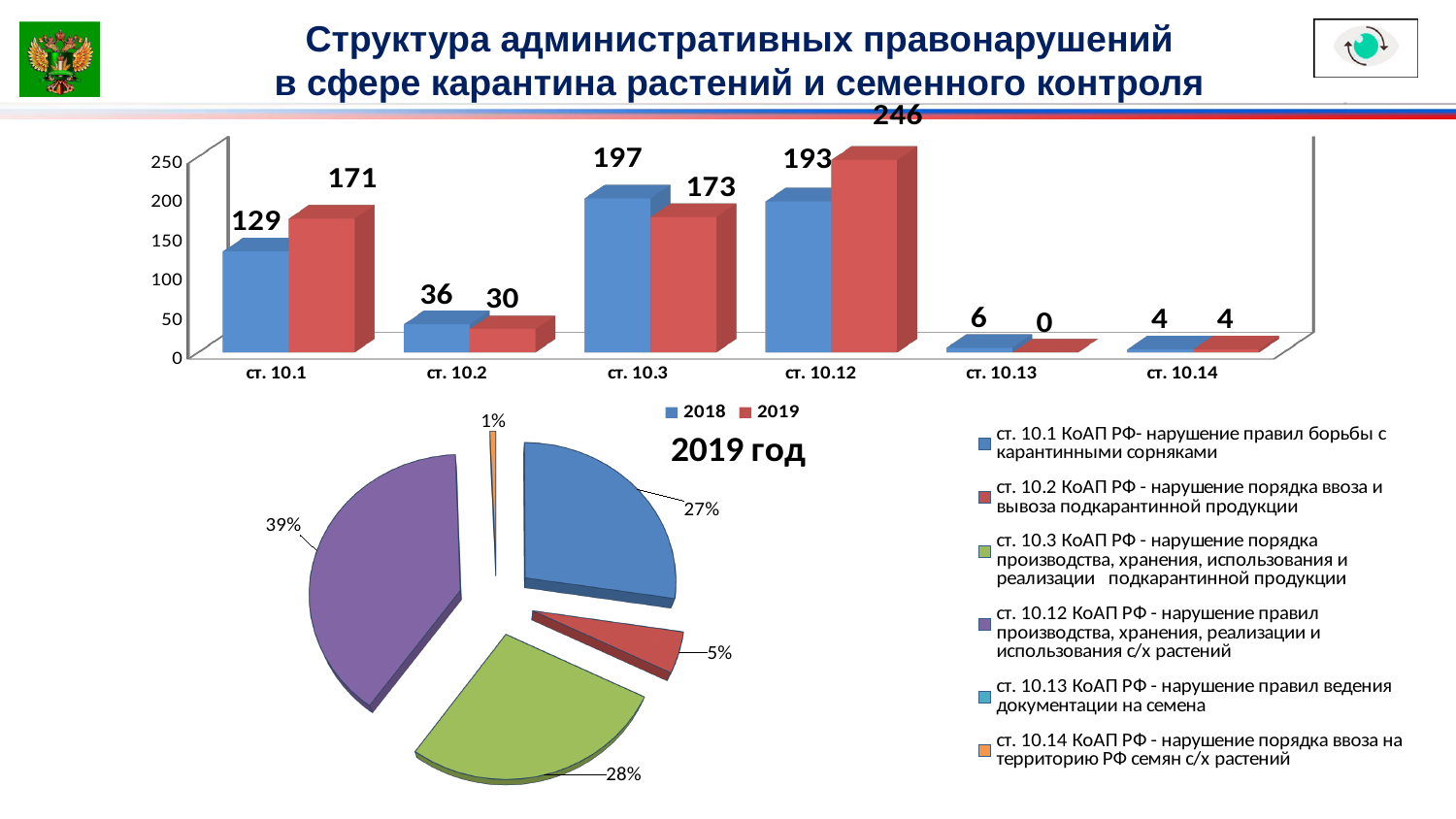
What type of chart is the upper chart on the slide? bar chart In the bar chart, what is the value for ст. 10.13 in 2018? 6 In the bar chart, what is the value for ст. 10.1 in 2019? 171 In the bar chart, what is the value for ст. 10.3 in 2018? 197 In the bar chart, how many series does the legend list? 2 In the pie chart titled 2019 год, what share does the slice for ст. 10.2 КоАП РФ have? 5% In the pie chart titled 2019 год, what share does the largest slice have? 39% In the bar chart, which category has the highest value for 2019? ст. 10.12 In the bar chart, which category has the lowest value for 2019? ст. 10.13 In the bar chart, what is the difference between the 2019 and 2018 values for ст. 10.12? 53 In the bar chart, which is larger for ст. 10.3: the 2018 value or the 2019 value? 2018 In the bar chart, how many categories are shown on the x axis? 6